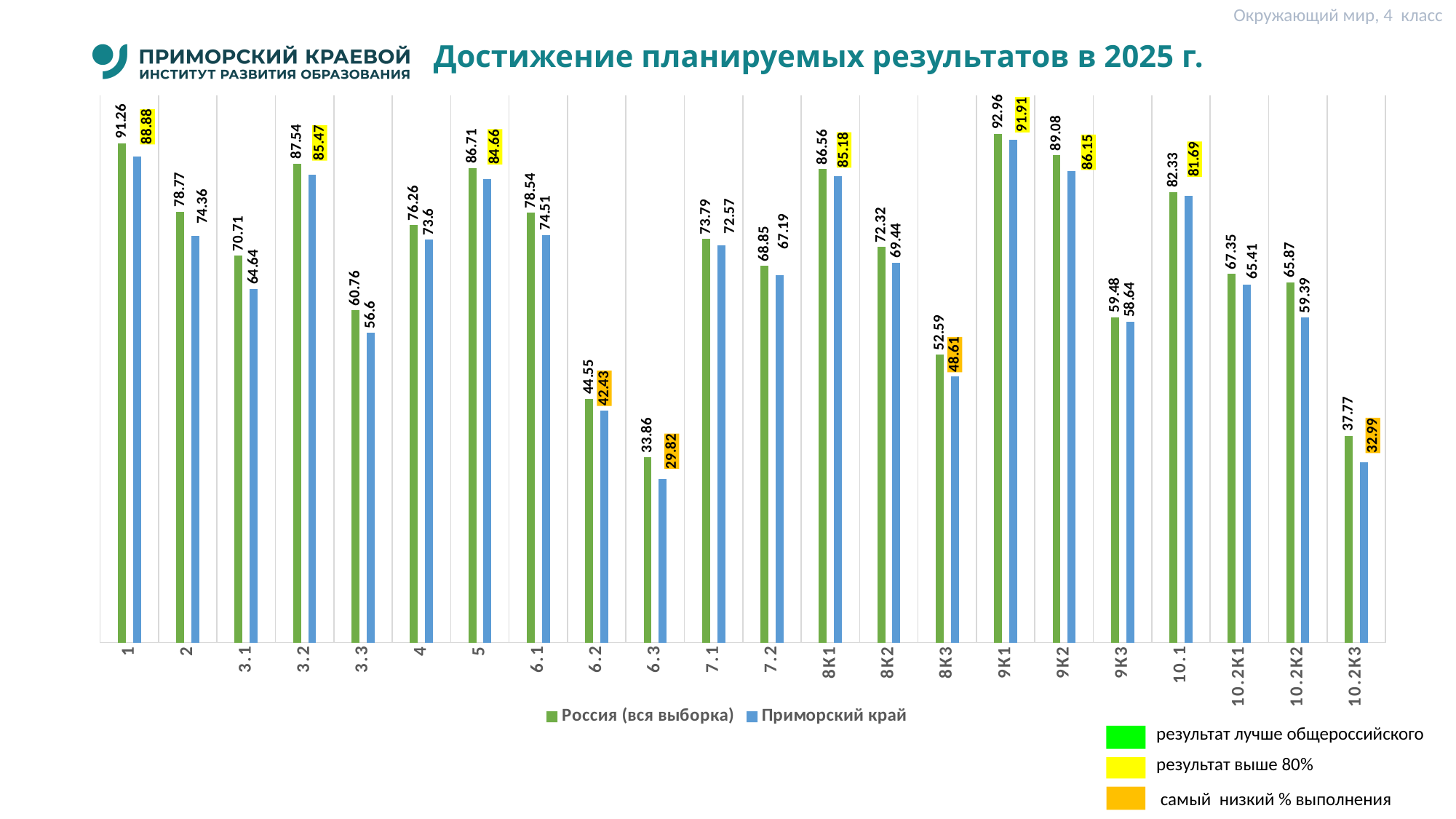
What is the difference between Россия (вся выборка) and Приморский край for category 10.2К2? 6.48 What is the value for Приморский край for category 10.2К3? 32.99 Which category has the highest value for Приморский край? 9К1 Which category has the lowest value for Приморский край? 6.3 What is the value for Россия (вся выборка) for category 3.2? 87.54 Which category has the lowest value for Россия (вся выборка)? 6.3 What is the value for Приморский край for category 9К1? 91.91 What is the difference between Россия (вся выборка) and Приморский край for category 1? 2.38 What is the value for Россия (вся выборка) for category 6.3? 33.86 Which is larger for category 8К3: Россия (вся выборка) or Приморский край? Россия (вся выборка) How many series does the chart legend list? 2 How many categories are shown on the x axis? 22